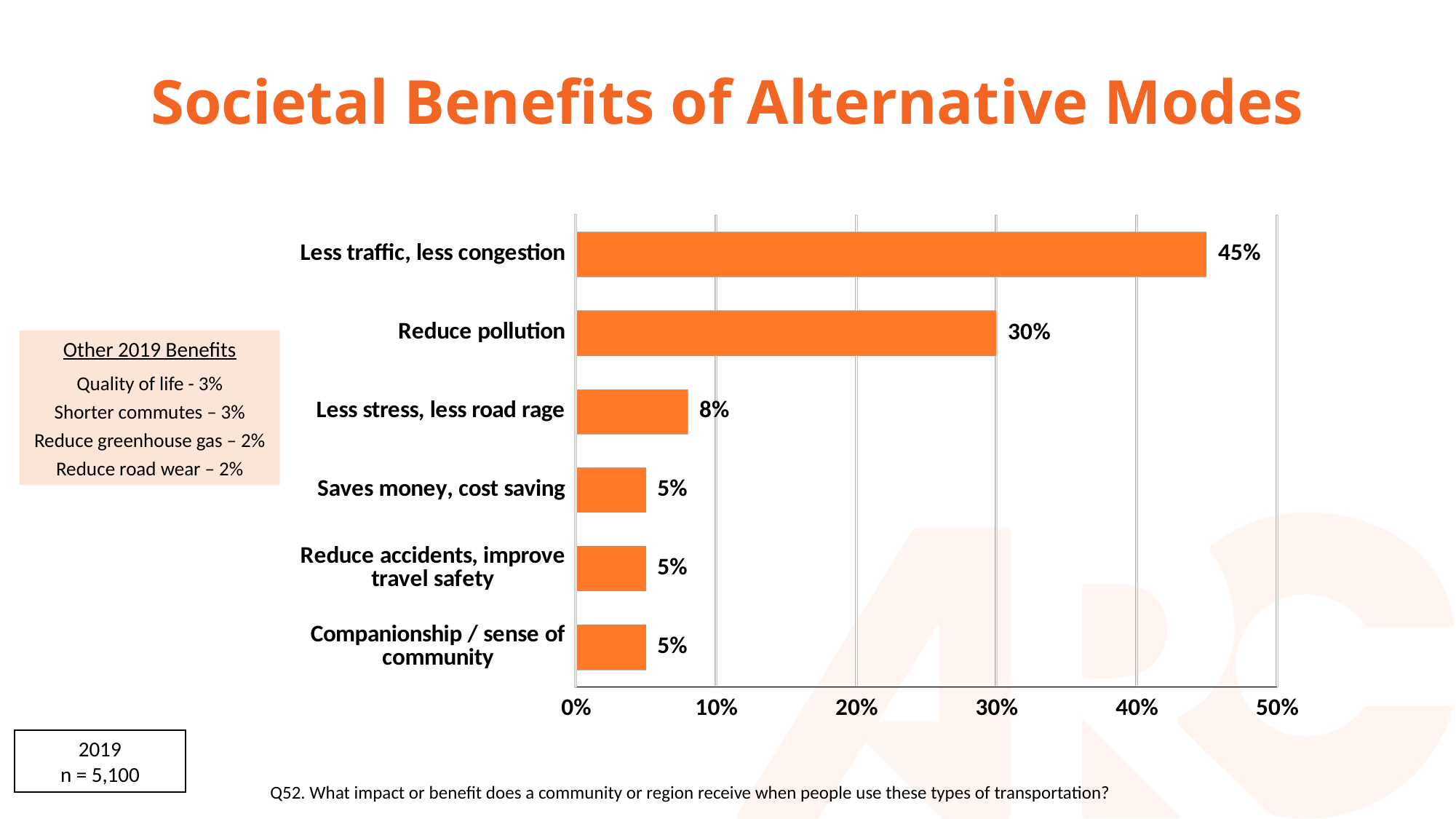
Which is larger, Reduce pollution or Less stress, less road rage? Reduce pollution What is the difference between Less traffic, less congestion and Reduce pollution? 15% Which category has the highest value? Less traffic, less congestion Is the value for Less traffic, less congestion greater or less than 40%? greater What is the value for Reduce pollution? 30% What is the difference between Reduce pollution and Less stress, less road rage? 22% How many categories are shown in the chart? 6 What is the value for Saves money, cost saving? 5% What kind of chart is shown on the slide? bar chart What is the value for Less traffic, less congestion? 45% What is the value for Less stress, less road rage? 8% What is the title of the slide? Societal Benefits of Alternative Modes